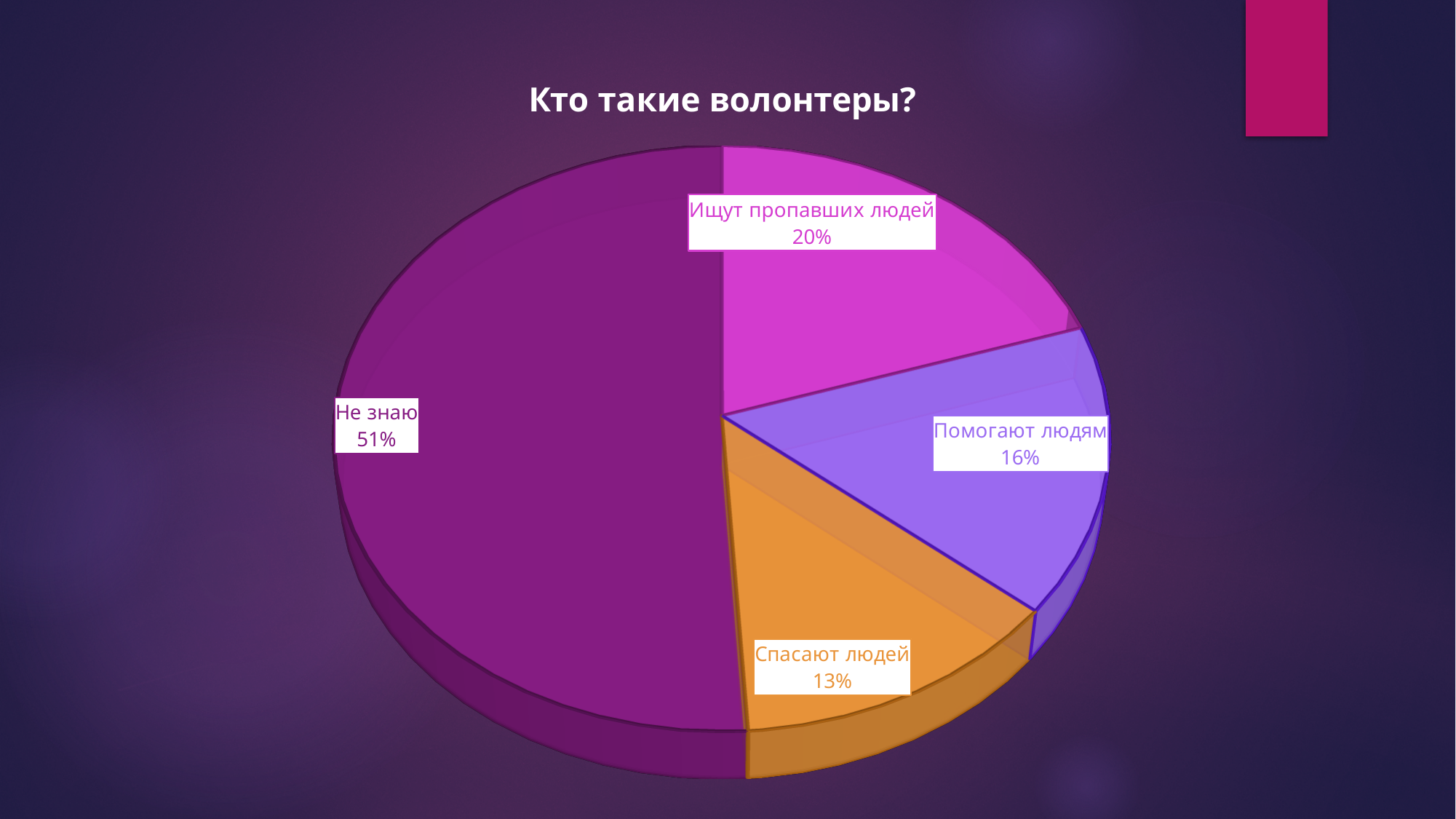
How many slices does the pie chart have? 4 What percentage is shown for "Помогают людям"? 16% What percentage is shown for "Ищут пропавших людей"? 20% What percentage is shown for "Спасают людей"? 13% What colour is the "Спасают людей" slice? orange Which category has the smallest share of the pie? Спасают людей What percentage is shown for "Не знаю"? 51% What is the difference in percentage points between "Не знаю" and "Ищут пропавших людей"? 31 Which category has the largest share of the pie? Не знаю Which is larger, the share for "Помогают людям" or the share for "Спасают людей"? Помогают людям What kind of chart is shown on the slide? pie chart What is the title of the chart? Кто такие волонтеры?